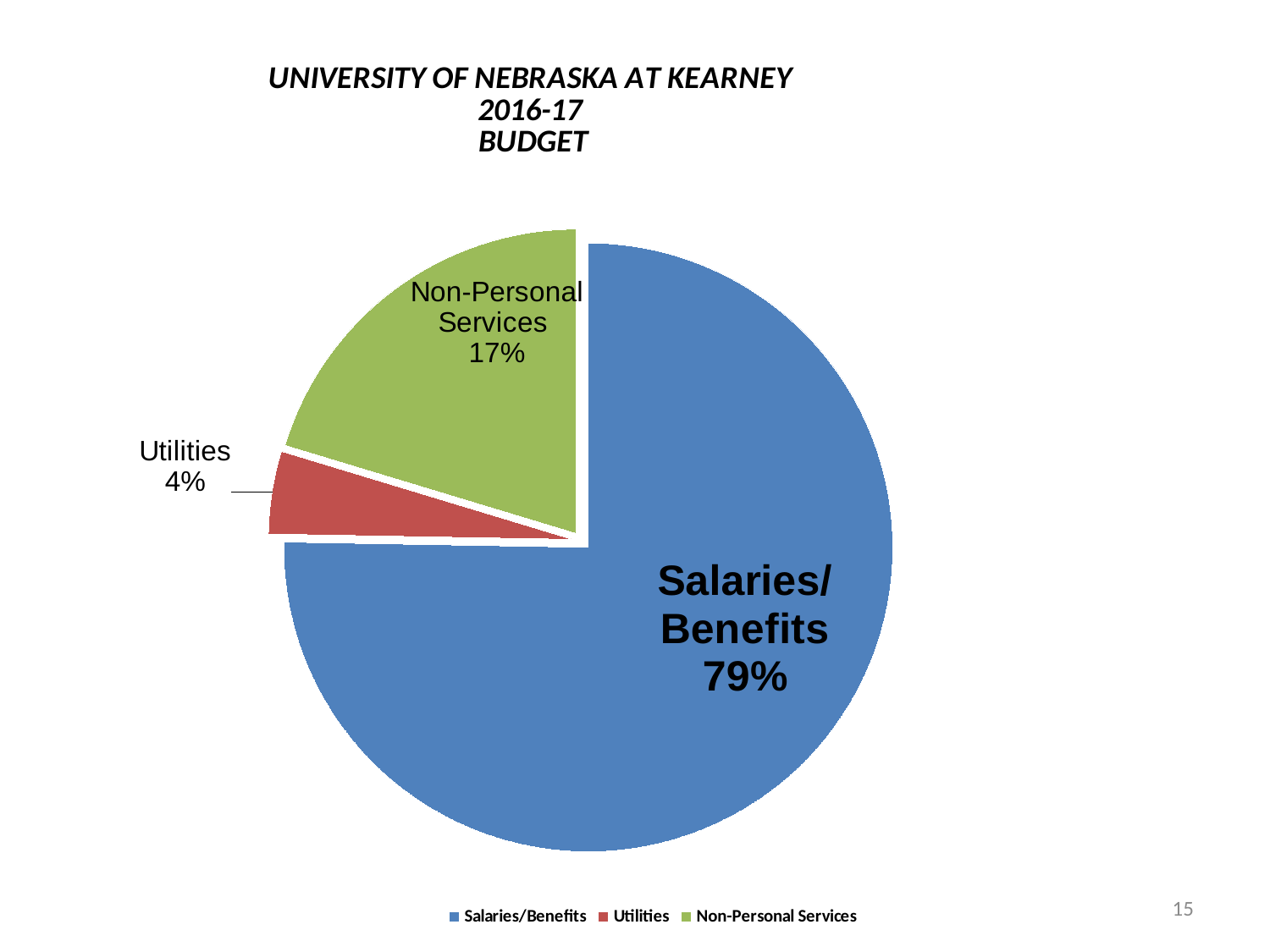
What share of the budget goes to Utilities? 4% What kind of chart is shown on the slide? Pie chart What share of the budget goes to Salaries/Benefits? 79% Which is larger, the share for Utilities or the share for Non-Personal Services? Non-Personal Services How many entries does the legend list? 3 What is the difference in percentage points between Salaries/Benefits and Non-Personal Services? 62 How many slices does the pie chart have? 3 Which category has the smallest share of the budget? Utilities Which category has the largest share of the budget? Salaries/Benefits What is the difference in percentage points between Non-Personal Services and Utilities? 13 What colour is the Utilities slice? Red What share of the budget goes to Non-Personal Services? 17%